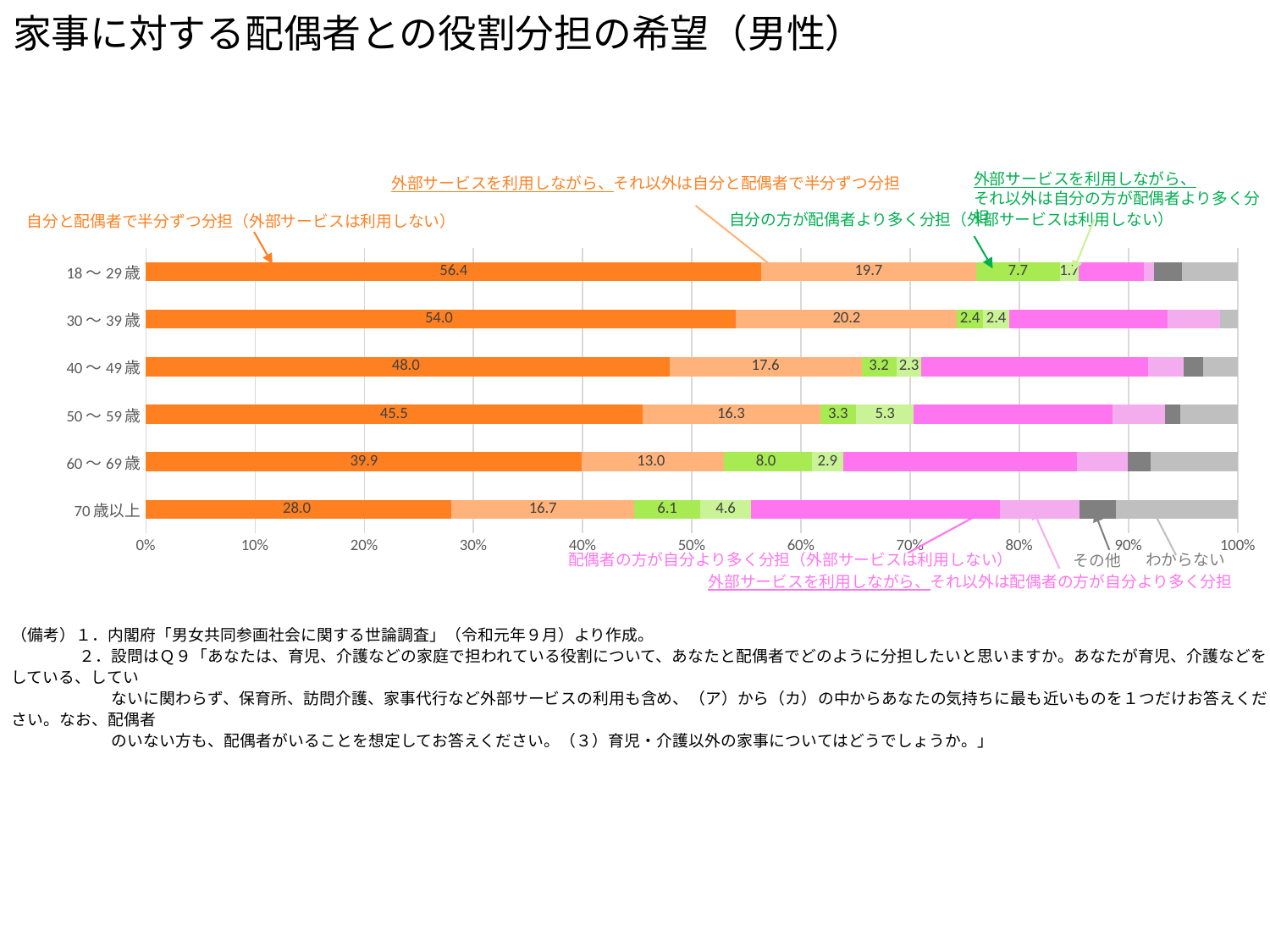
What is the value for 60～69歳 in the 自分の方が配偶者より多く分担（外部サービスは利用しない） series? 8.0 What kind of chart is shown on the slide? Stacked bar chart What is the value for 50～59歳 in the 外部サービスを利用しながら、それ以外は自分と配偶者で半分ずつ分担 series? 16.3 Which has the larger value in the 外部サービスを利用しながら、それ以外は自分の方が配偶者より多く分担 series: 50～59歳 or 40～49歳? 50～59歳 What is the value for 70歳以上 in the 自分と配偶者で半分ずつ分担（外部サービスは利用しない） series? 28.0 How many age groups are shown on the chart? 6 Which age group has the lowest value for 自分と配偶者で半分ずつ分担（外部サービスは利用しない）? 70歳以上 What is the value for 18～29歳 in the 自分と配偶者で半分ずつ分担（外部サービスは利用しない） series? 56.4 Does the value for 自分と配偶者で半分ずつ分担（外部サービスは利用しない） rise or fall as the age group gets older? Falls Which age group has the highest value for 自分と配偶者で半分ずつ分担（外部サービスは利用しない）? 18～29歳 What is the difference between the 自分と配偶者で半分ずつ分担（外部サービスは利用しない） values for 18～29歳 and 70歳以上? 28.4 What is the value for 30～39歳 in the 外部サービスを利用しながら、それ以外は自分と配偶者で半分ずつ分担 series? 20.2